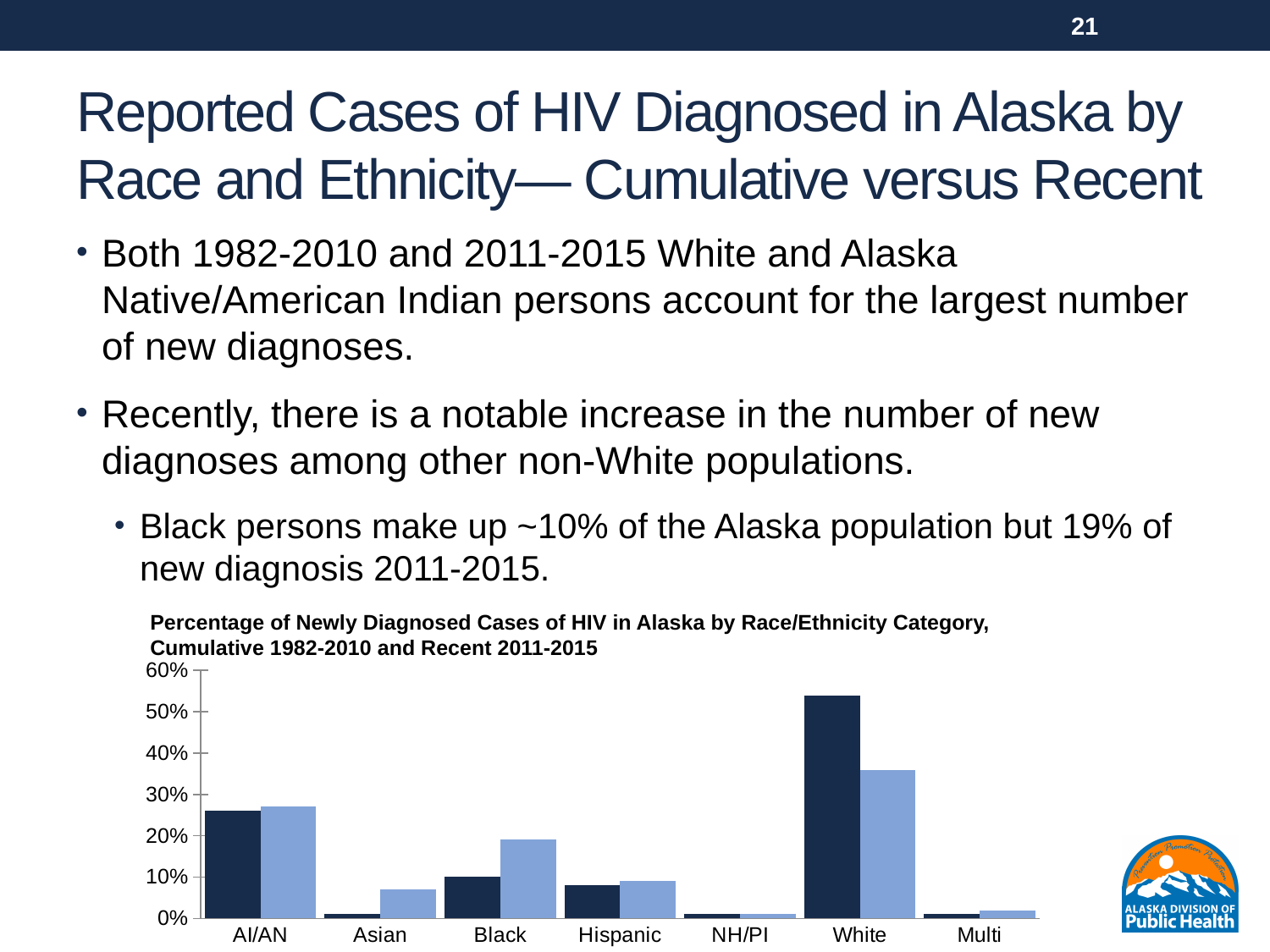
Is the dark blue bar for White greater or less than 50%? greater What is the highest value shown on the chart's y axis? 60% What kind of chart is shown on the slide? bar chart For the White category, which bar is taller, the dark blue bar or the light blue bar? dark blue bar For the Black category, which bar is taller, the dark blue bar or the light blue bar? light blue bar Is the light blue bar for White greater or less than 40%? less What is the title of the chart? Percentage of Newly Diagnosed Cases of HIV in Alaska by Race/Ethnicity Category, Cumulative 1982-2010 and Recent 2011-2015 Is the dark blue bar for AI/AN greater or less than 20%? greater Which category has the tallest dark blue bar in the chart? White How many race/ethnicity categories are shown on the x axis of the chart? 7 Which category has the tallest light blue bar in the chart? White